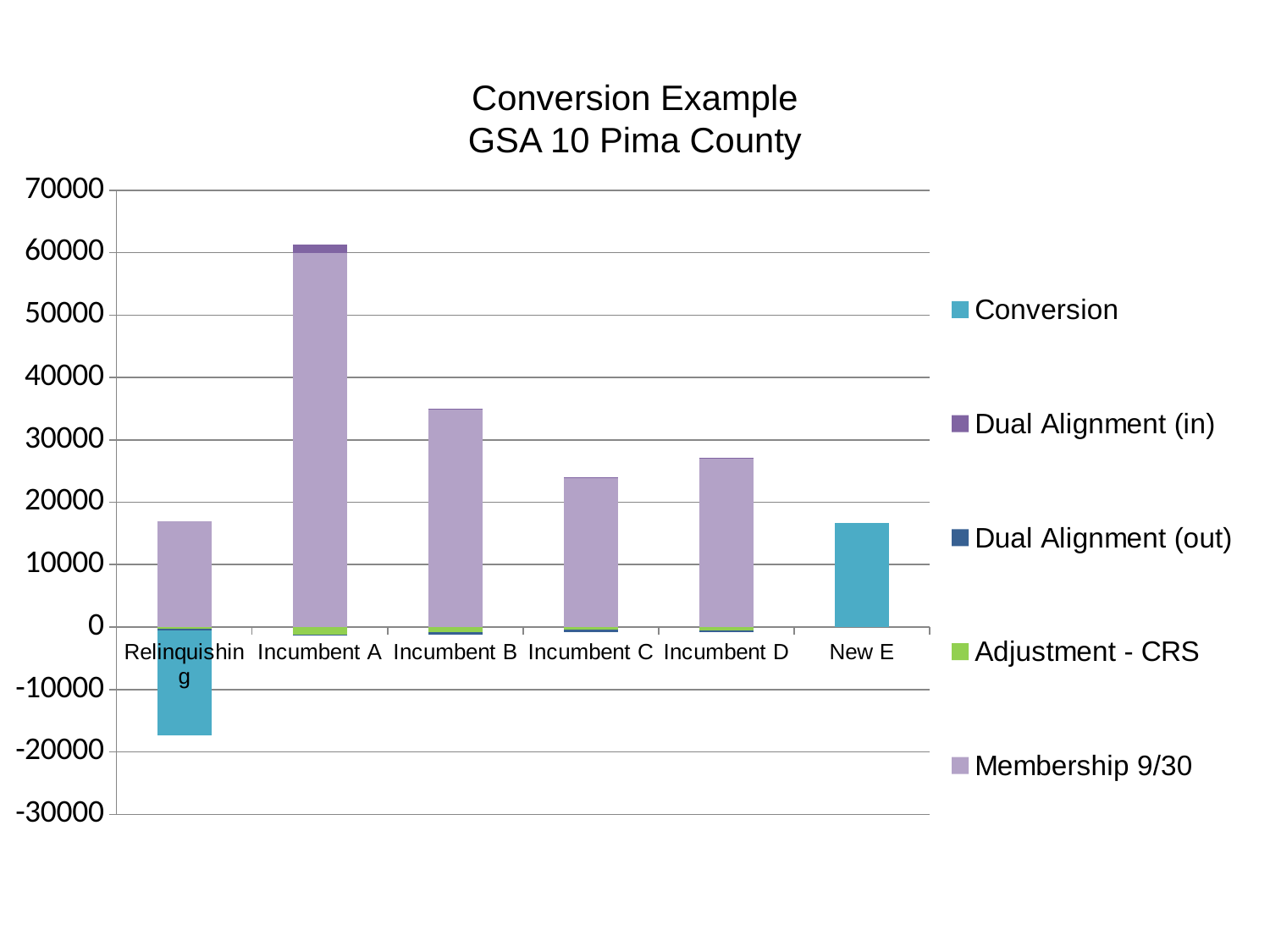
Is the Conversion value for Relinquishing greater or less than -10000? less Which category is the only one with a positive Conversion bar? New E Is the Conversion value for New E greater or less than 20000? less Is the Membership 9/30 value for Incumbent A greater or less than 50000? greater Which category has the highest Membership 9/30 value? Incumbent A What kind of chart is shown on the slide? Stacked bar chart Which has a larger Membership 9/30 value, Incumbent B or Incumbent D? Incumbent B How many categories are shown along the x axis? 6 How many series does the legend list? 5 Which category has the lowest Membership 9/30 value among the incumbents (A, B, C, D)? Incumbent C What is the title of the chart? Conversion Example GSA 10 Pima County